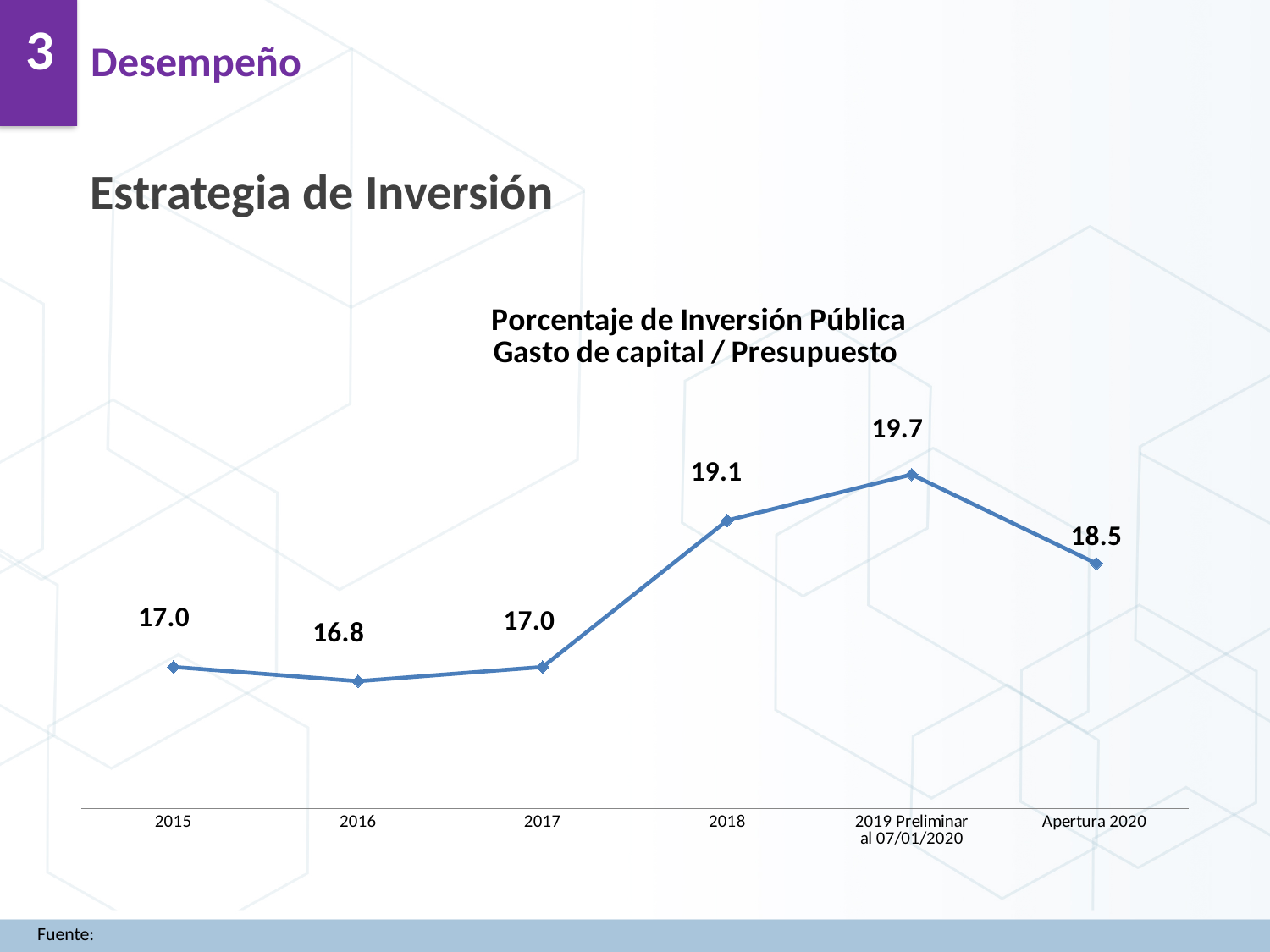
What is the value for 2016? 16.8 What is the value for 2015? 17.0 What kind of chart is shown? Line chart What is the value for 2019 Preliminar al 07/01/2020? 19.7 Which category has the highest value? 2019 Preliminar al 07/01/2020 What is the value for 2018? 19.1 Which category has the lowest value? 2016 Which is larger, the value for Apertura 2020 or the value for 2018? 2018 How many data points are plotted on the chart? 6 What is the value for Apertura 2020? 18.5 What is the title of the chart? Porcentaje de Inversión Pública Gasto de capital / Presupuesto What is the difference between the values for 2018 and 2017? 2.1